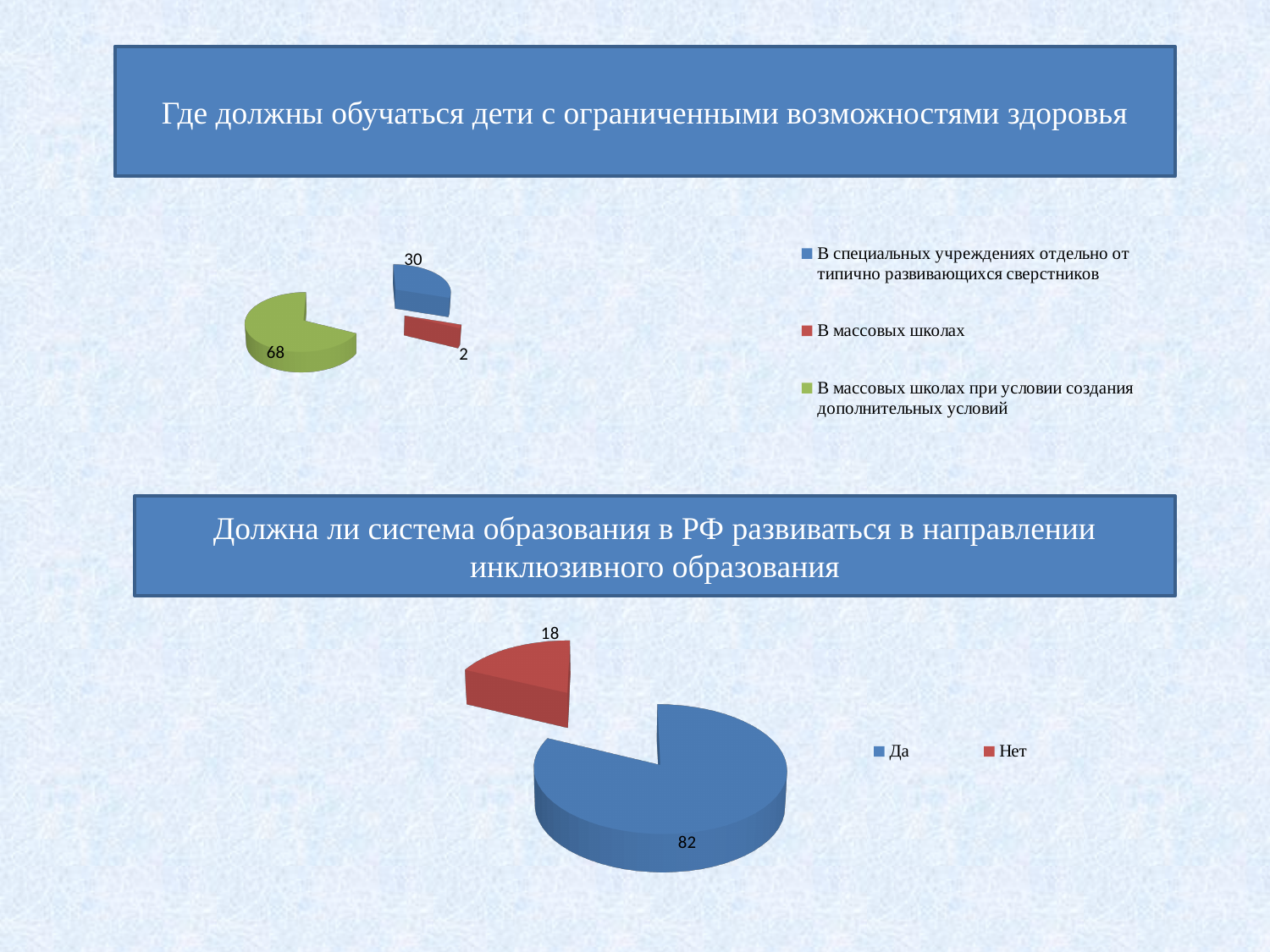
On the bottom chart, which is larger, 'Да' or 'Нет'? Да What kind of chart is the bottom chart? Pie chart On the bottom chart (Должна ли система образования в РФ развиваться в направлении инклюзивного образования), what is the value for 'Да'? 82 On the top chart, how many categories does the legend list? 3 On the top chart, what is the value for 'В специальных учреждениях отдельно от типично развивающихся сверстников'? 30 On the bottom chart, what is the value for 'Нет'? 18 On the top chart, what is the difference between the values for 'В массовых школах при условии создания дополнительных условий' and 'В специальных учреждениях отдельно от типично развивающихся сверстников'? 38 On the top chart, what is the value for 'В массовых школах'? 2 On the top chart, which category has the largest slice? В массовых школах при условии создания дополнительных условий On the top chart (Где должны обучаться дети с ограниченными возможностями здоровья), what is the value for 'В массовых школах при условии создания дополнительных условий'? 68 On the top chart, which category has the smallest slice? В массовых школах On the bottom chart, what is the difference between the values for 'Да' and 'Нет'? 64